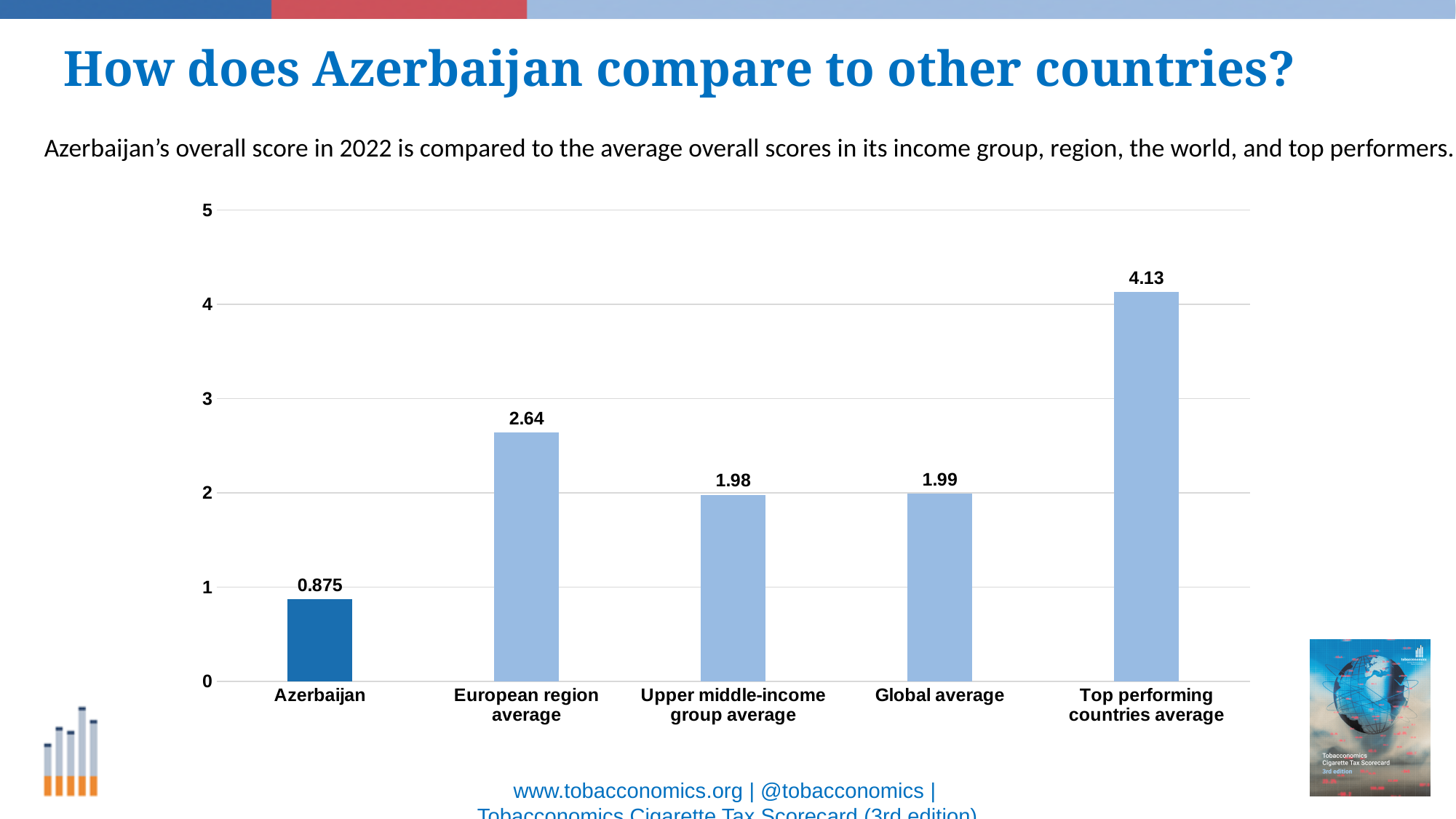
Which category has the lowest value? Azerbaijan What is the value for the Top performing countries average? 4.13 What is the value for the Upper middle-income group average? 1.98 What is the value for the European region average? 2.64 Is the value for the Top performing countries average greater or less than 4? greater What is the value for Azerbaijan? 0.875 What is the difference between the European region average and the Global average? 0.65 How many categories are shown on the chart? 5 What is the difference between the Top performing countries average and Azerbaijan? 3.255 What kind of chart is shown on the slide? Bar chart Which category has the highest value? Top performing countries average Which is larger, the European region average or the Global average? European region average